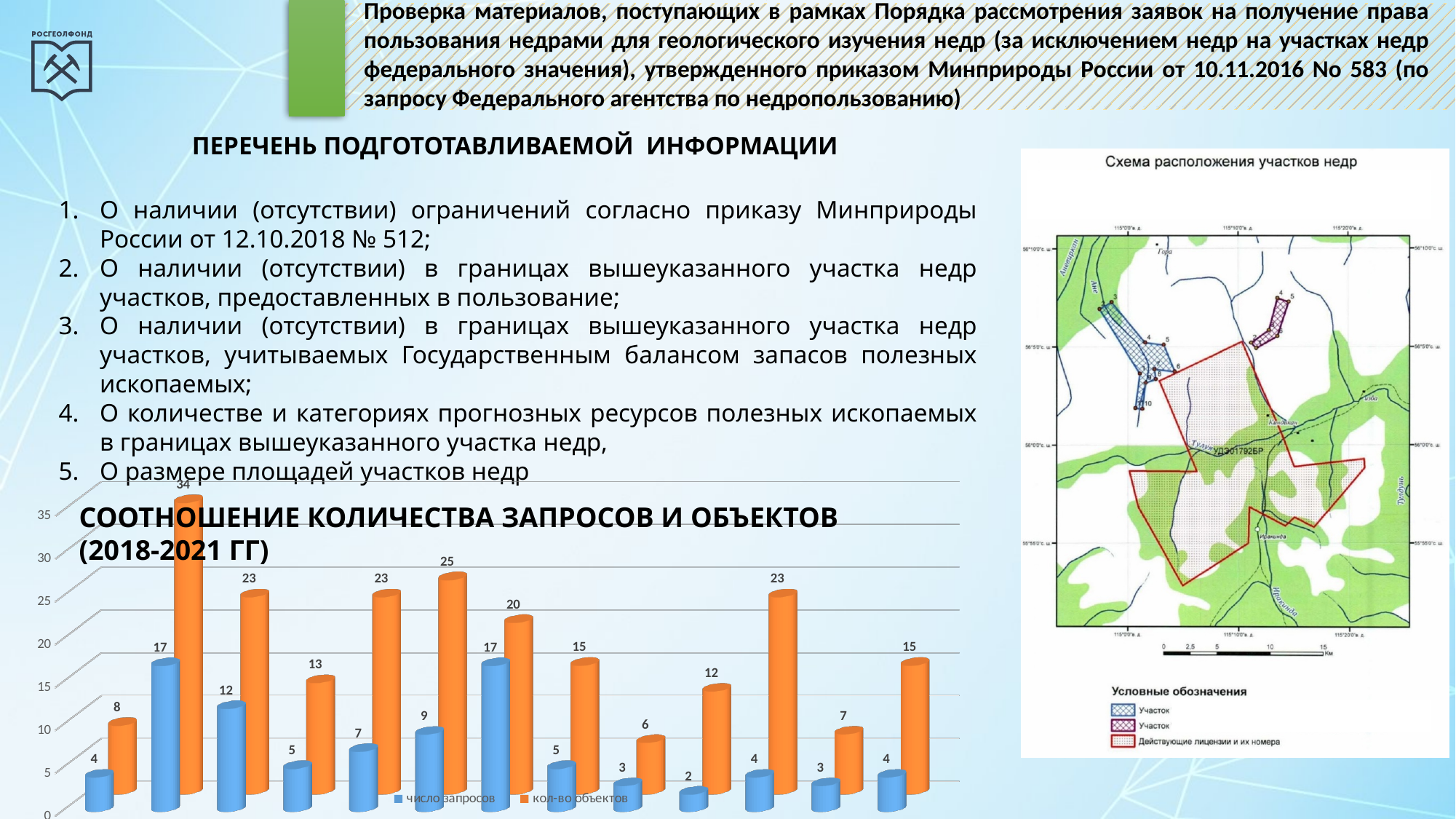
How many groups of bars are plotted in the bar chart? 13 In the leftmost group of the bar chart, which series has the larger value, 'число запросов' or 'кол-во объектов'? кол-во объектов In the rightmost group of the bar chart, what is the value of 'кол-во объектов'? 15 What are the two series named in the legend of the bar chart? число запросов, кол-во объектов In the leftmost group of the bar chart, what is the value of 'число запросов'? 4 In the group where 'кол-во объектов' is 34, what is the difference between 'кол-во объектов' and 'число запросов'? 17 What kind of chart is shown at the bottom left of the slide? bar chart What is the highest value of the 'кол-во объектов' series in the bar chart? 34 What is the lowest value of the 'число запросов' series in the bar chart? 2 How many series does the legend of the bar chart list? 2 What is the lowest value of the 'кол-во объектов' series in the bar chart? 6 What is the title of the bar chart? СООТНОШЕНИЕ КОЛИЧЕСТВА ЗАПРОСОВ И ОБЪЕКТОВ (2018-2021 ГГ)